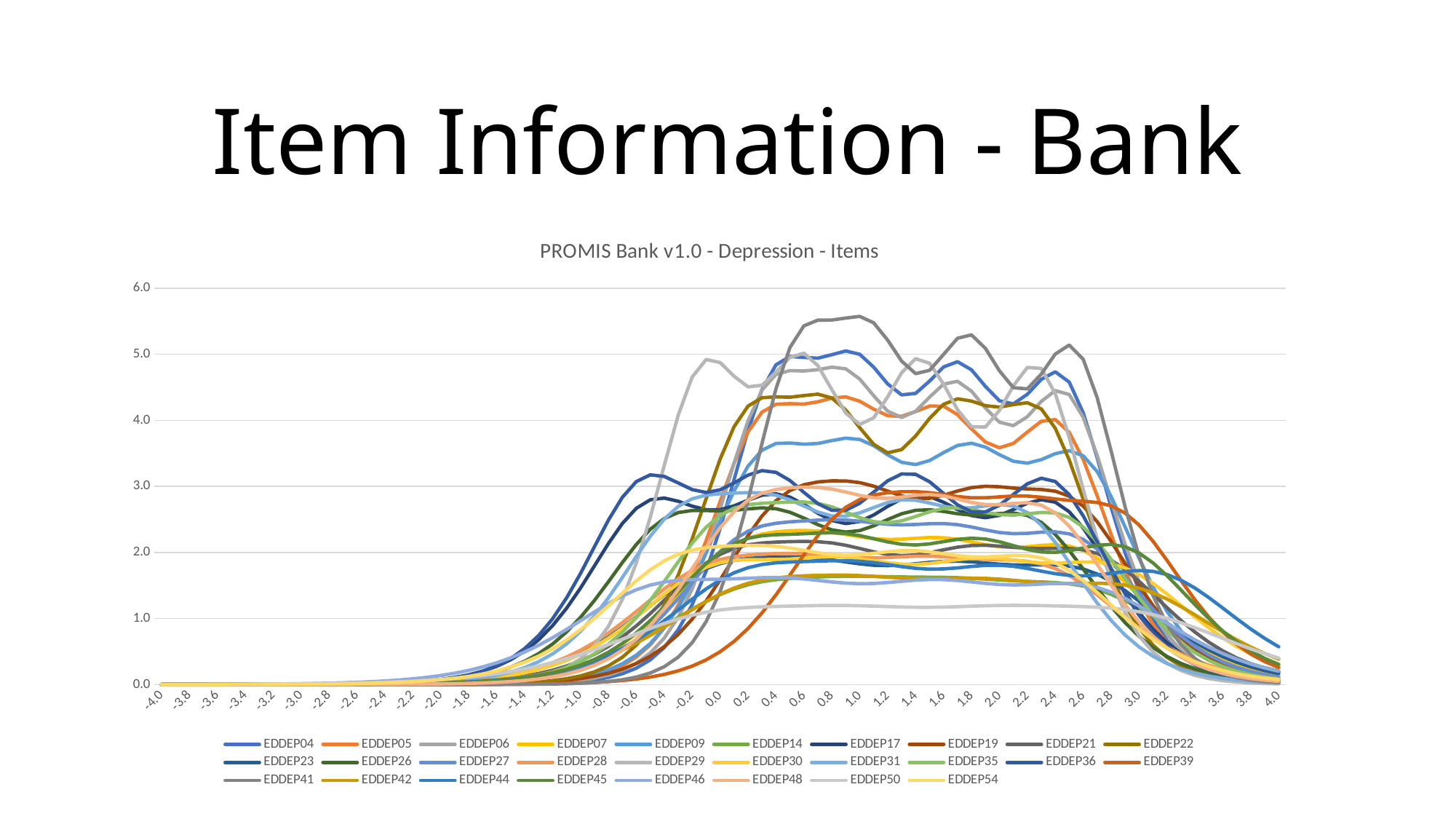
How many series does the legend list? 28 How many tick labels are shown on the x axis? 41 Do the lines generally rise or fall along the x axis between 3.0 and 4.0? fall What is the last entry in the chart's legend? EDDEP54 Is the highest peak reached by any line greater or less than 5.0? greater What is the title of the chart? PROMIS Bank v1.0 - Depression - Items Do the lines generally rise or fall along the x axis between -4.0 and 0.0? rise What kind of chart is shown on the slide? line chart Is the highest peak reached by any line greater or less than 6.0? less